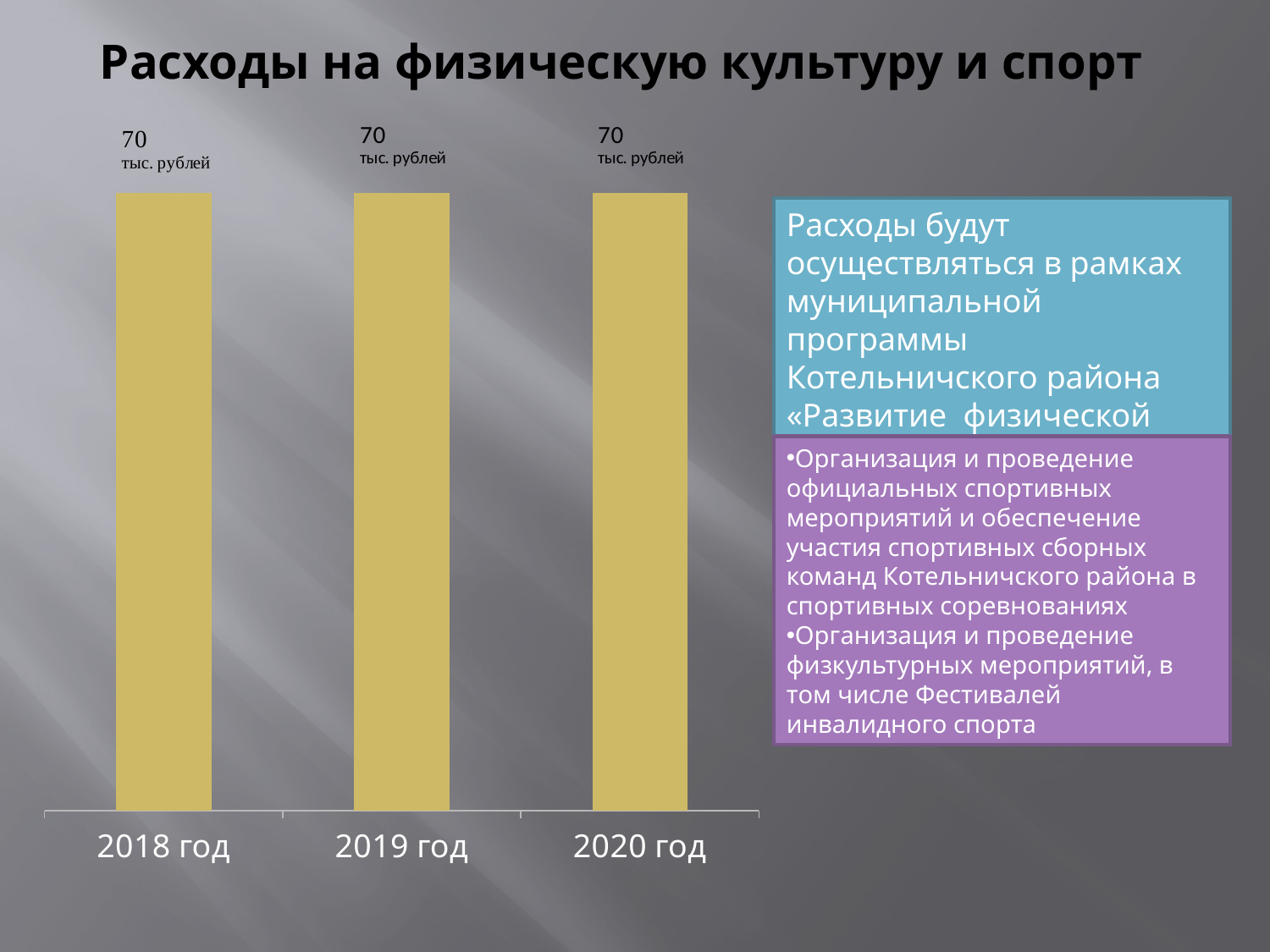
What is the difference between the values for 2020 год and 2019 год? 0 What colour are the bars in the chart? yellow Do the values rise, fall, or stay the same from 2018 год to 2020 год? stay the same Which year is the first category on the x axis? 2018 год What is the value for 2018 год? 70 тыс. рублей What is the value for 2019 год? 70 тыс. рублей What is the value for 2020 год? 70 тыс. рублей How many bars (years) are shown in the chart? 3 In what units are the chart values given? тыс. рублей What kind of chart is shown on the slide? bar chart What is the title of the slide containing the chart? Расходы на физическую культуру и спорт What is the difference between the values for 2019 год and 2018 год? 0